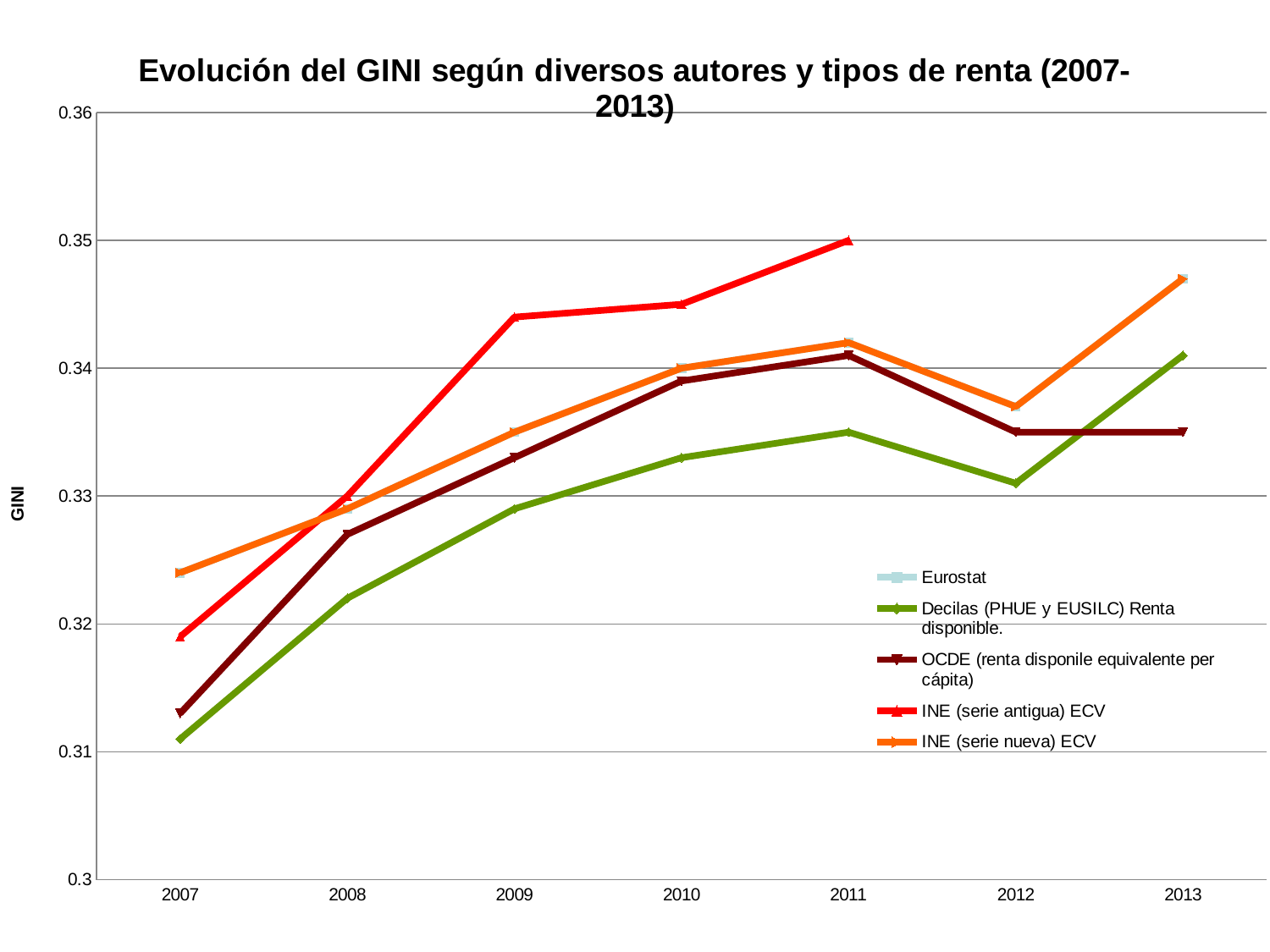
How many series does the legend list? 5 Which series has the lowest value in 2007? Decilas (PHUE y EUSILC) Renta disponible. Is the value for INE (serie nueva) ECV in 2013 greater or less than 0.34? greater How many years are shown on the x axis? 7 Which series reaches the highest value on the chart? INE (serie antigua) ECV Is the value for Decilas (PHUE y EUSILC) Renta disponible in 2007 greater or less than 0.32? less In 2009, which is larger: INE (serie antigua) ECV or OCDE (renta disponile equivalente per cápita)? INE (serie antigua) ECV What kind of chart is shown on the slide? line chart What is the label of the y axis? GINI What is the title of the chart? Evolución del GINI según diversos autores y tipos de renta (2007-2013) Is the value for INE (serie antigua) ECV in 2009 greater or less than 0.34? greater Does the INE (serie antigua) ECV series rise or fall from 2007 to 2011? rise